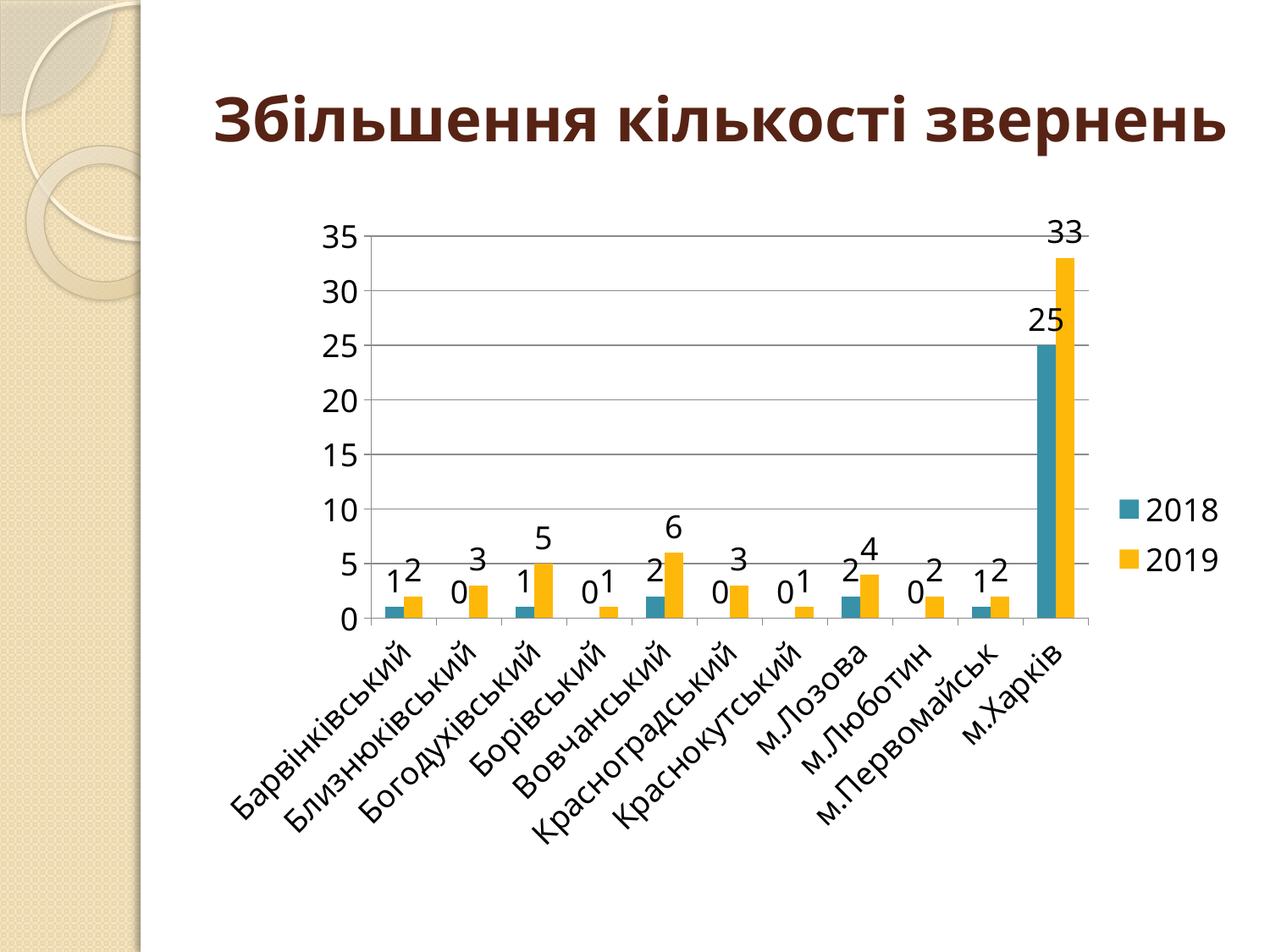
How many categories are shown on the x axis? 11 What is the difference between the 2019 and 2018 values for м.Харків? 8 Which category has the highest value in 2019? м.Харків How many series does the legend list? 2 Is the 2019 value for м.Харків greater or less than 30? greater What is the value for Вовчанський in 2019? 6 What type of chart is shown on the slide? Bar chart What is the value for м.Харків in 2019? 33 Which category has the highest value in 2018 apart from м.Харків, among Богодухівський and Вовчанський? Вовчанський What is the value for Близнюківський in 2018? 0 What is the value for м.Харків in 2018? 25 Is the 2019 value for Богодухівський larger than the 2019 value for м.Лозова? Yes